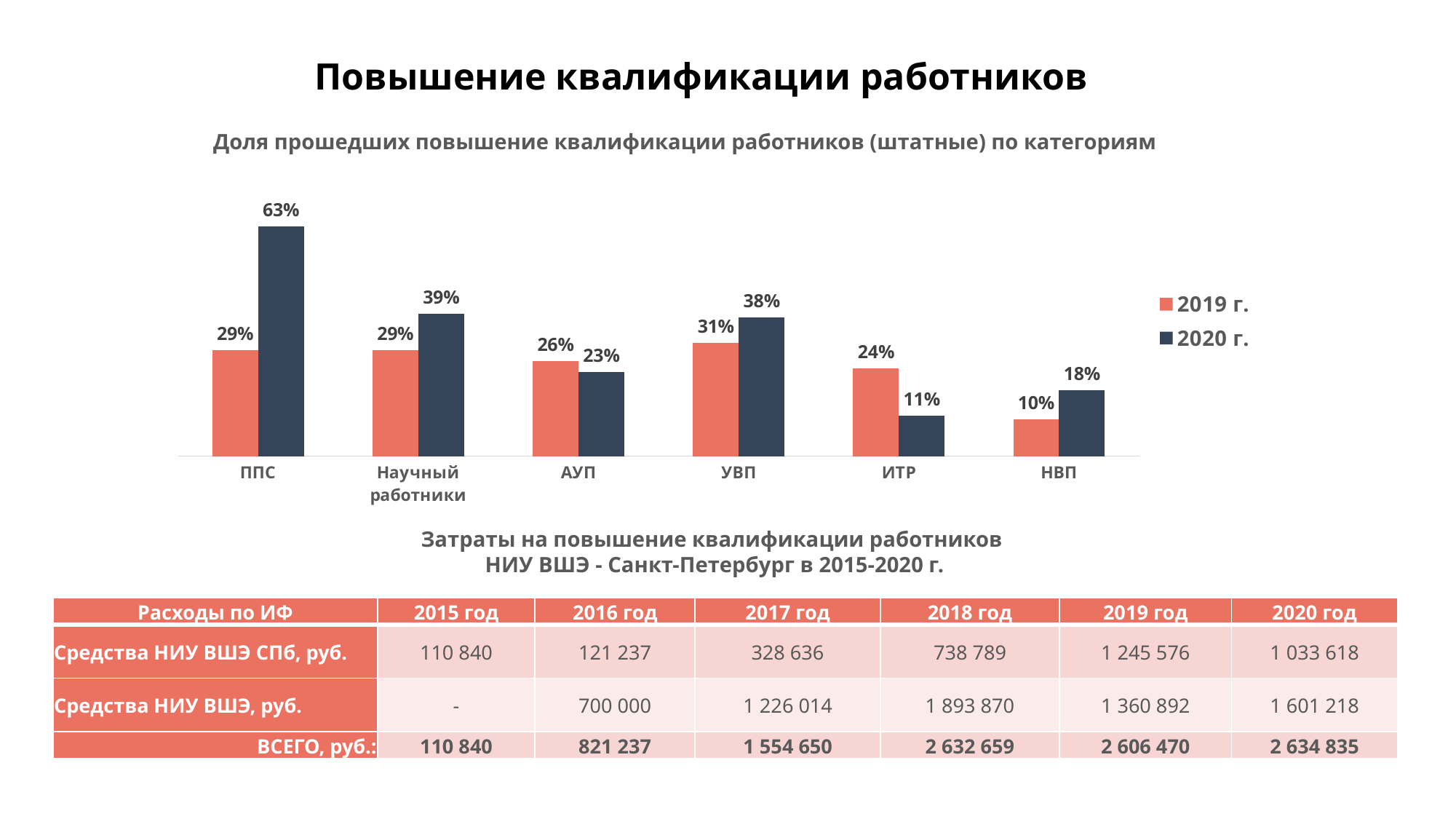
What kind of chart is shown on the slide? Bar chart How many series does the chart legend list? 2 What is the difference between the 2019 г. and 2020 г. values for ИТР? 13% Which category has the highest value in 2020 г.? ППС What is the value for НВП in 2020 г.? 18% Which category has the lowest value in 2019 г.? НВП Which is larger for АУП: the 2019 г. value or the 2020 г. value? 2019 г. What is the value for ИТР in 2019 г.? 24% How many categories are shown on the x axis of the chart? 6 What is the difference between the 2020 г. and 2019 г. values for ППС? 34% What is the value for УВП in 2019 г.? 31% What is the value for ППС in 2020 г.? 63%